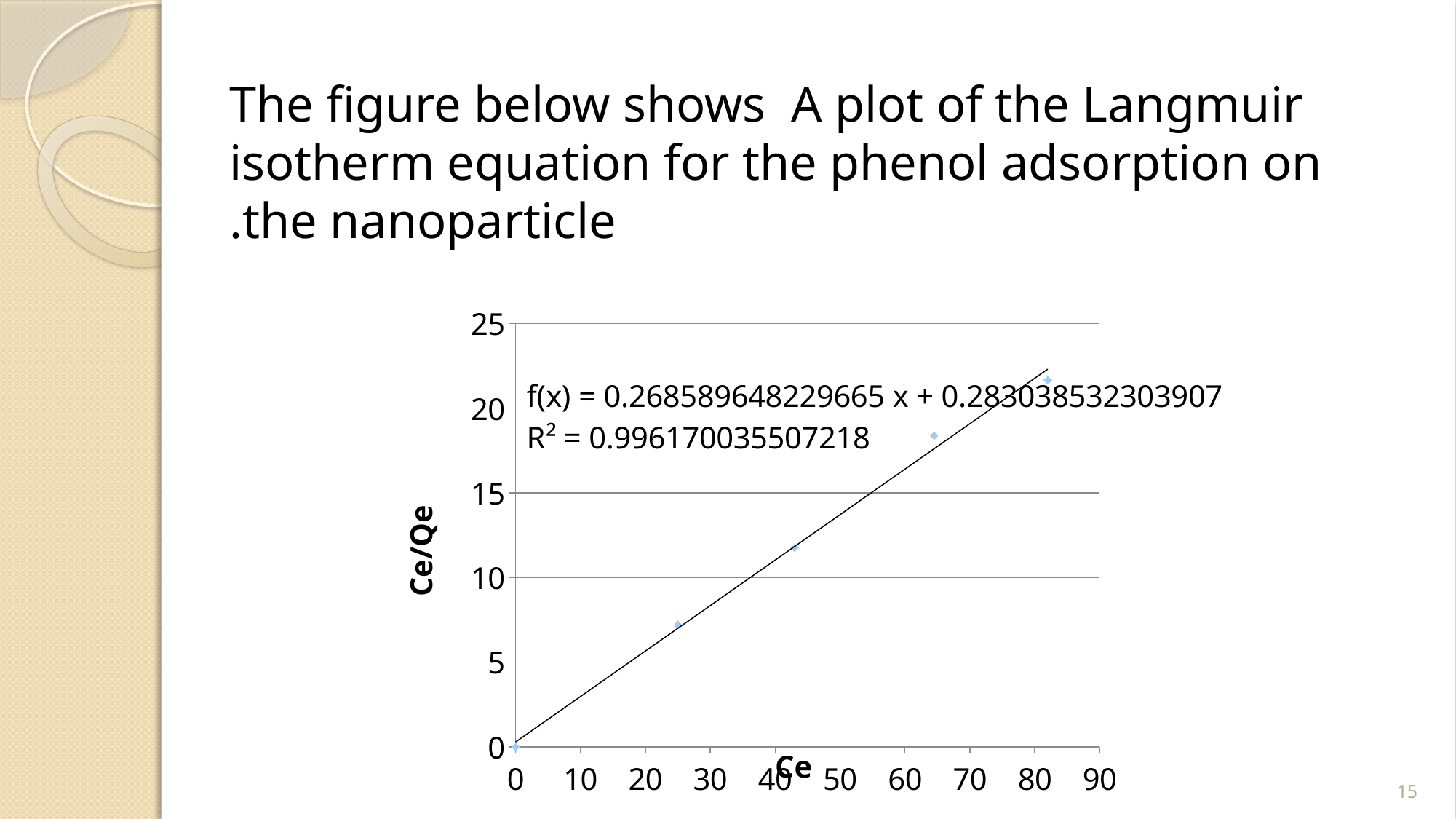
Is the Ce/Qe value of the data point near Ce = 65 greater or less than 15? greater What is the label of the y axis? Ce/Qe How many data points are plotted on the chart? 5 Do the Ce/Qe values rise or fall as Ce increases along the x axis? Rise Is the Ce/Qe value of the data point near Ce = 65 greater or less than 20? less What is the highest value shown on the y axis? 25 Which data point has the highest Ce/Qe value: the one near Ce = 45 or the one near Ce = 80? The one near Ce = 80 Is the Ce/Qe value of the rightmost data point greater or less than 20? greater What kind of chart is shown on the slide? Scatter plot with a trendline What is the label of the x axis? Ce